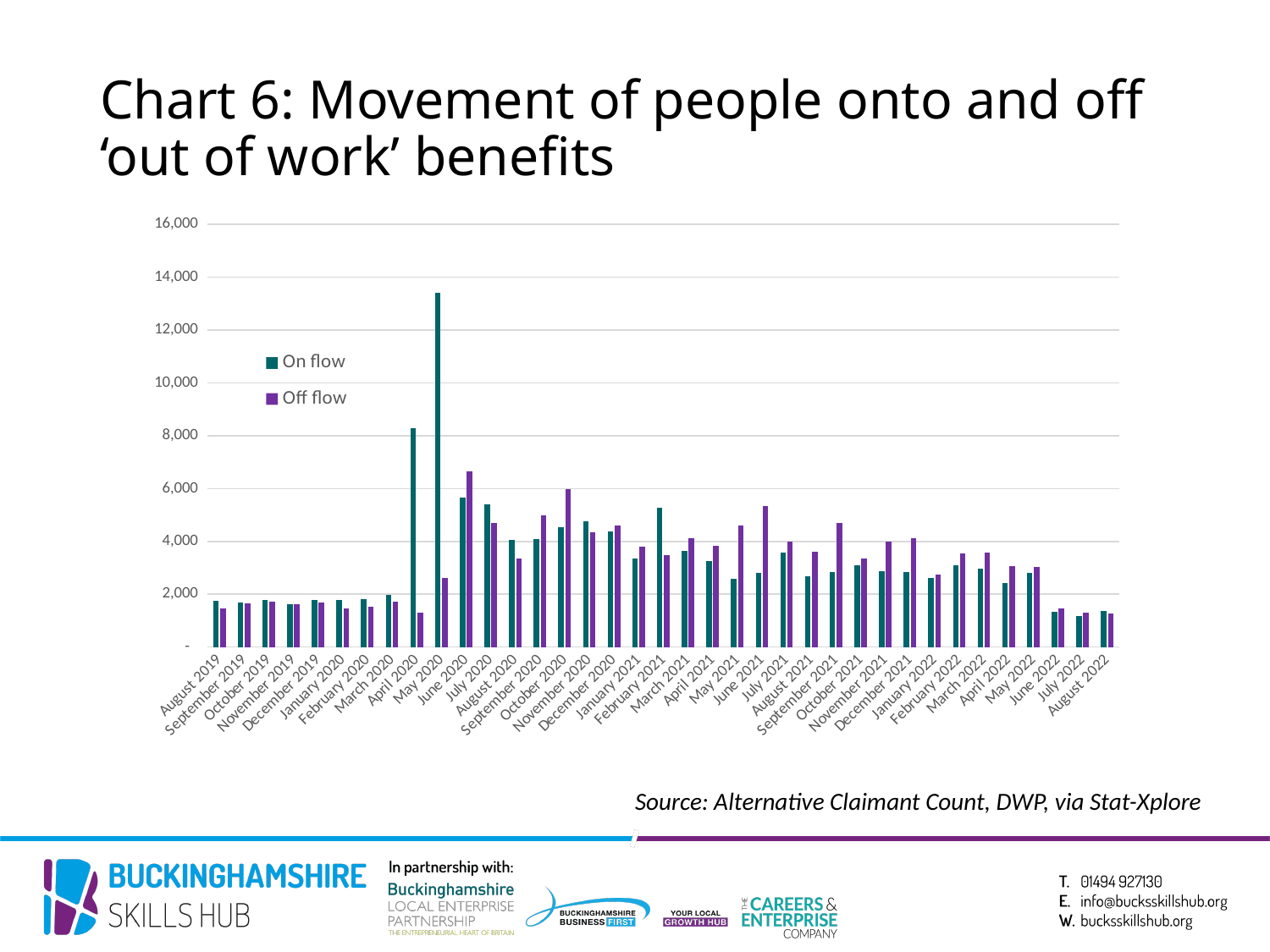
In which month is the On flow value highest? May 2020 Does the On flow value generally rise or fall from May 2020 to August 2022? fall How many months are shown along the x axis? 37 What kind of chart is shown on the slide? Bar chart In July 2021, which is larger: On flow or Off flow? Off flow In May 2020, which is larger: On flow or Off flow? On flow Is the On flow value for April 2020 greater or less than 6,000? greater Is the On flow value for May 2020 greater or less than 12,000? greater How many series does the legend list? 2 In which month is the Off flow value highest? June 2020 What are the two series named in the legend? On flow and Off flow Is the On flow value for August 2019 greater or less than 2,000? less